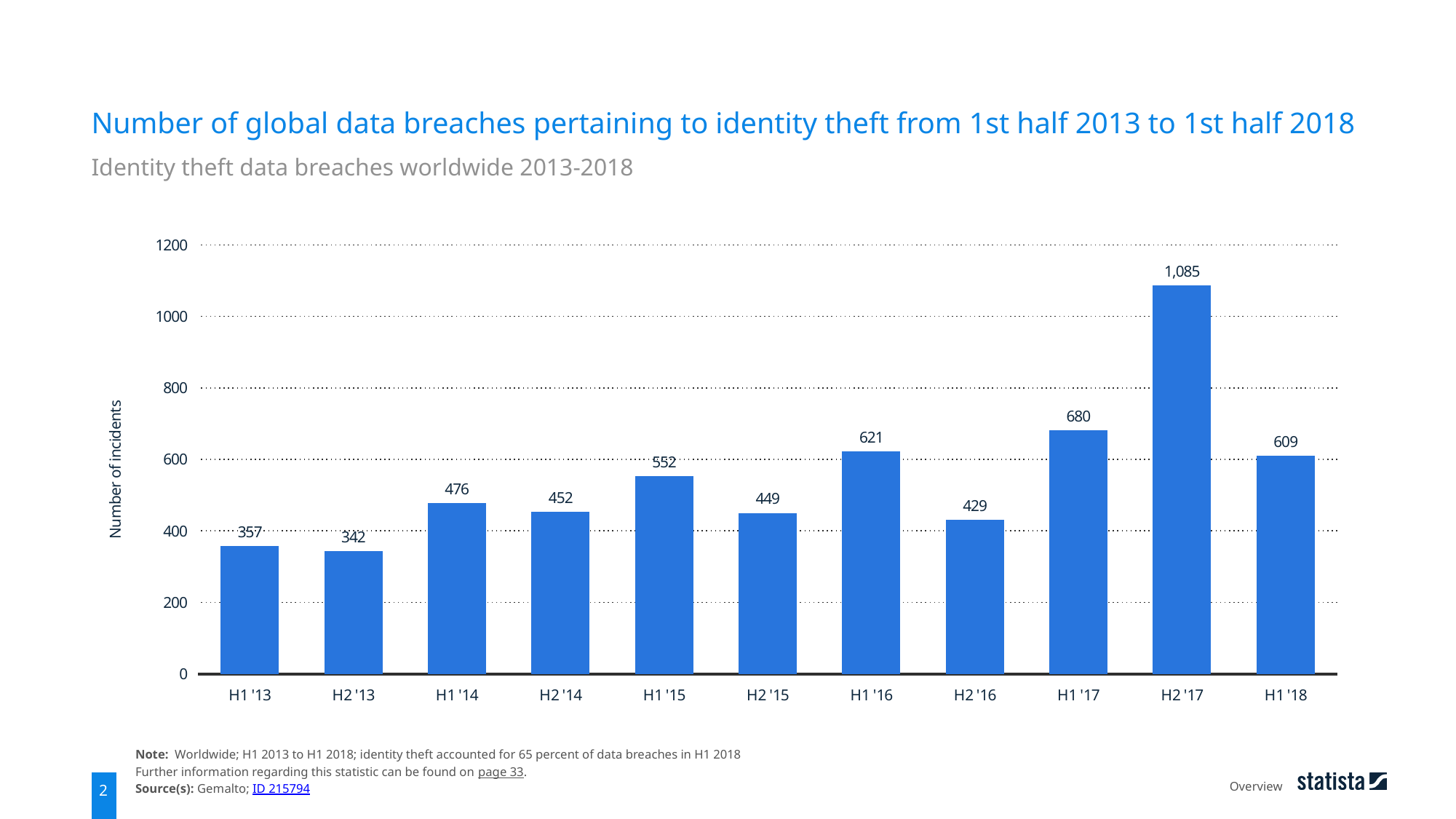
What is the difference in incidents between H1 '17 and H2 '16? 251 What is the number of incidents for H1 '13? 357 Which has more incidents, H1 '15 or H2 '15? H1 '15 What is the number of incidents for H1 '16? 621 Is the value for H1 '17 greater or less than 600? greater How many periods are shown on the x axis? 11 Which period has the lowest number of incidents? H2 '13 Which period has the highest number of incidents? H2 '17 What is the number of incidents for H2 '17? 1,085 What is the difference in incidents between H2 '17 and H1 '18? 476 What kind of chart is shown on the slide? Bar chart What is the label of the y axis? Number of incidents